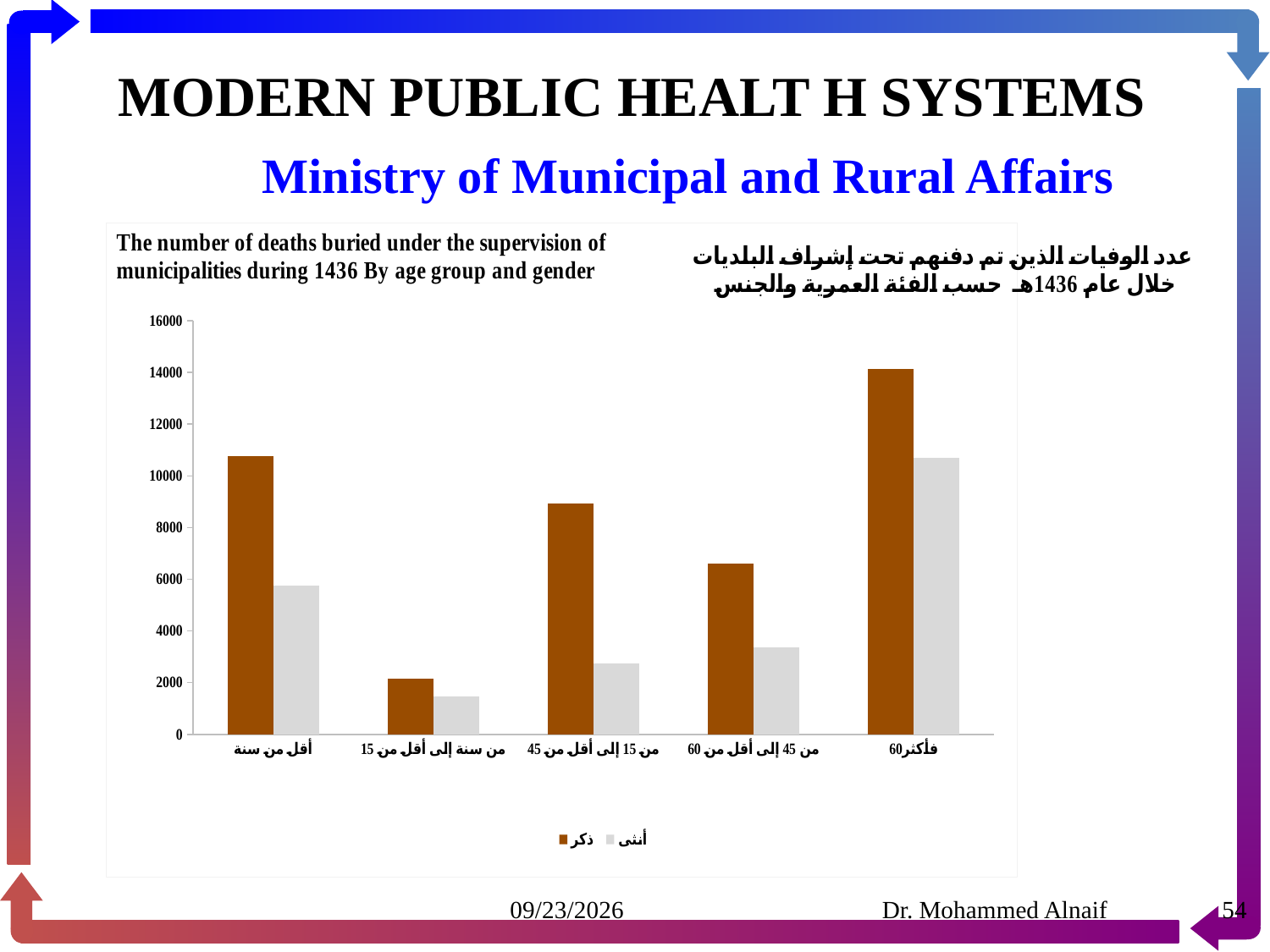
What kind of chart is shown on the slide? bar chart What is the English title of the chart? The number of deaths buried under the supervision of municipalities during 1436 By age group and gender How many series does the legend list? 2 Is the ذكر (male) value for من 15 إلى أقل من 45 greater or less than 8000? greater How many age-group categories are shown on the x axis? 5 Which age group has the lowest value for the أنثى (female) series? من سنة إلى أقل من 15 For the age group أقل من سنة, which series has the larger value, ذكر or أنثى? ذكر Which age group has the lowest value for the ذكر (male) series? من سنة إلى أقل من 15 Is the أنثى (female) value for أقل من سنة greater or less than 6000? less Which age group has the highest value for the ذكر (male) series? 60 فأكثر Which age group has the highest value for the أنثى (female) series? 60 فأكثر